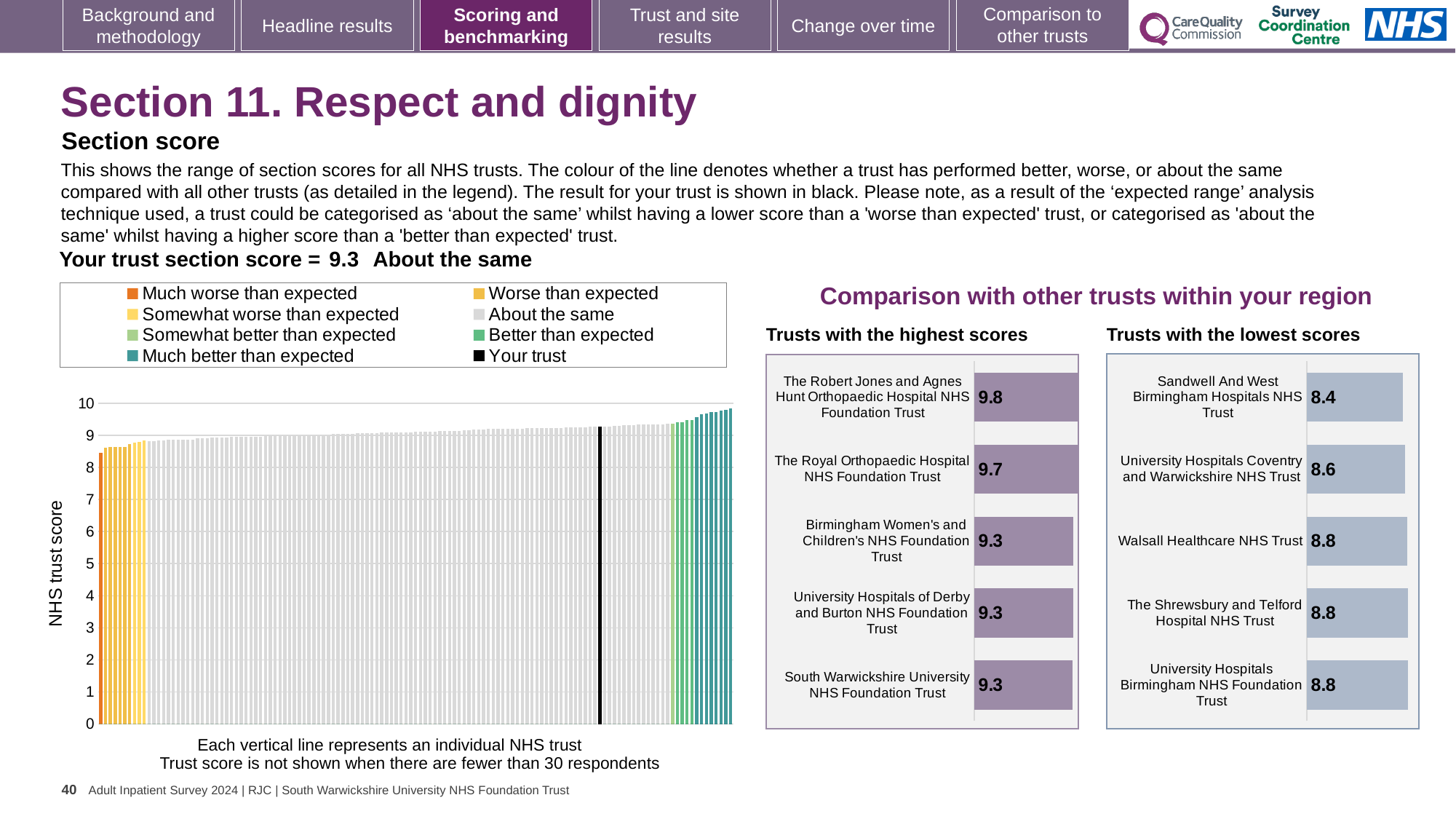
In the 'Trusts with the lowest scores' chart, which has the larger score: University Hospitals Coventry and Warwickshire NHS Trust or Walsall Healthcare NHS Trust? Walsall Healthcare NHS Trust In the large 'NHS trust score' chart, do the bar values rise or fall from left to right? Rise In the 'Trusts with the highest scores' chart, what is the score for The Royal Orthopaedic Hospital NHS Foundation Trust? 9.7 In the 'Trusts with the highest scores' chart, which trust has the highest score? The Robert Jones and Agnes Hunt Orthopaedic Hospital NHS Foundation Trust How many entries does the legend of the large 'NHS trust score' chart list? 8 What is the difference between the score of The Robert Jones and Agnes Hunt Orthopaedic Hospital NHS Foundation Trust in the highest scores chart and Sandwell And West Birmingham Hospitals NHS Trust in the lowest scores chart? 1.4 In the 'Trusts with the lowest scores' chart, which trust has the lowest score? Sandwell And West Birmingham Hospitals NHS Trust In the 'Trusts with the lowest scores' chart, what is the score for Sandwell And West Birmingham Hospitals NHS Trust? 8.4 In the 'Trusts with the lowest scores' chart, what is the score for University Hospitals Coventry and Warwickshire NHS Trust? 8.6 What kind of chart is the large chart with the 'NHS trust score' axis? Bar chart In the 'Trusts with the highest scores' chart, what is the score for The Robert Jones and Agnes Hunt Orthopaedic Hospital NHS Foundation Trust? 9.8 How many trusts are listed in the 'Trusts with the highest scores' chart? 5